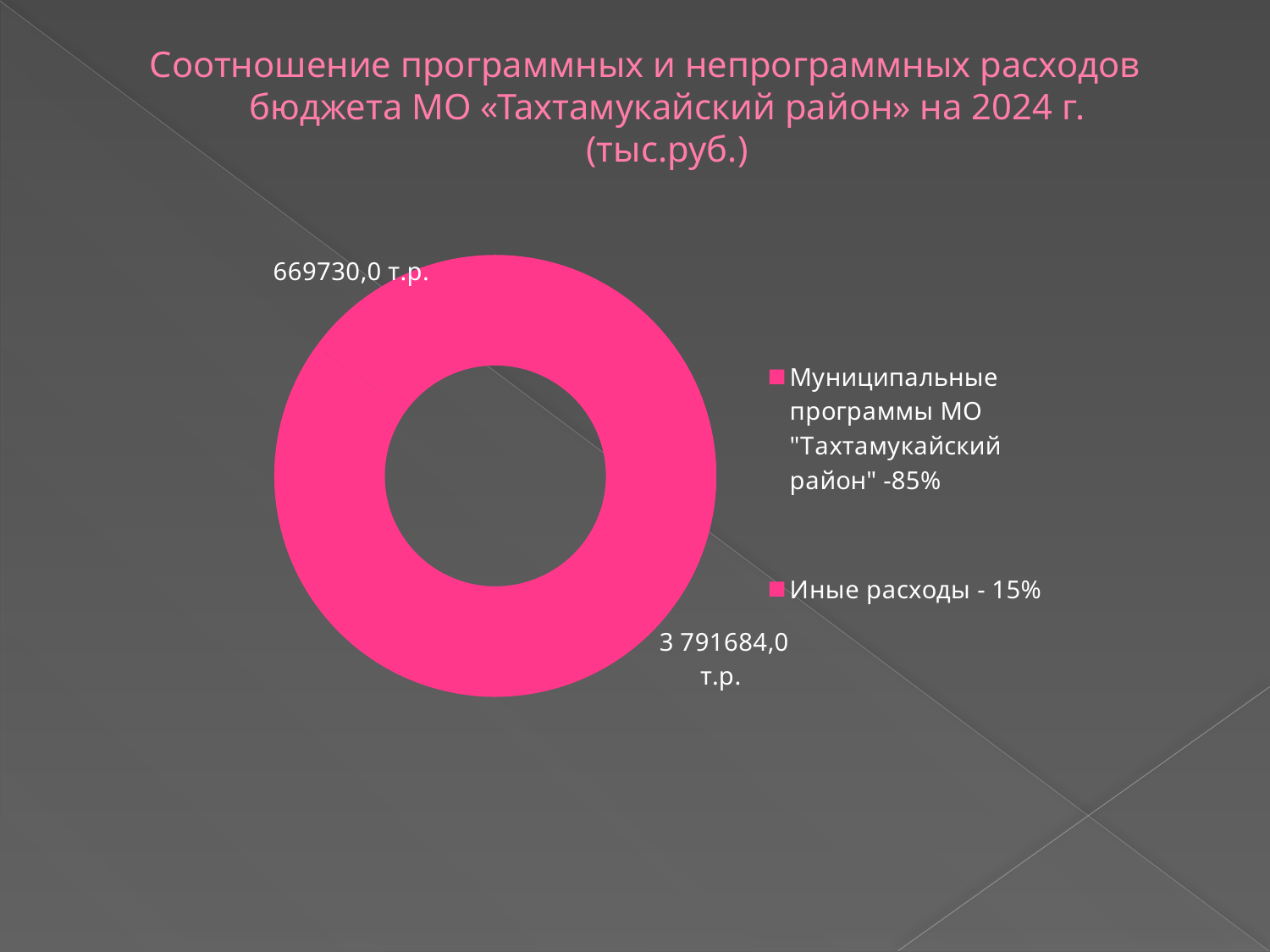
What is the difference between the value for Муниципальные программы and the value for Иные расходы? 3121954,0 т.р. Which category has the largest value? Муниципальные программы МО "Тахтамукайский район" What kind of chart is shown on the slide? doughnut (pie) chart How many entries does the legend list? 2 For which year does the chart title say the budget expenditures are shown? 2024 What share of the total do Иные расходы make up? 15% What is the value for Муниципальные программы МО "Тахтамукайский район"? 3 791684,0 т.р. What is the value for Иные расходы? 669730,0 т.р. What share of the total do Муниципальные программы МО "Тахтамукайский район" make up? 85% Which is larger: the value for Муниципальные программы or the value for Иные расходы? Муниципальные программы Which category has the smallest value? Иные расходы How many categories does the chart show? 2